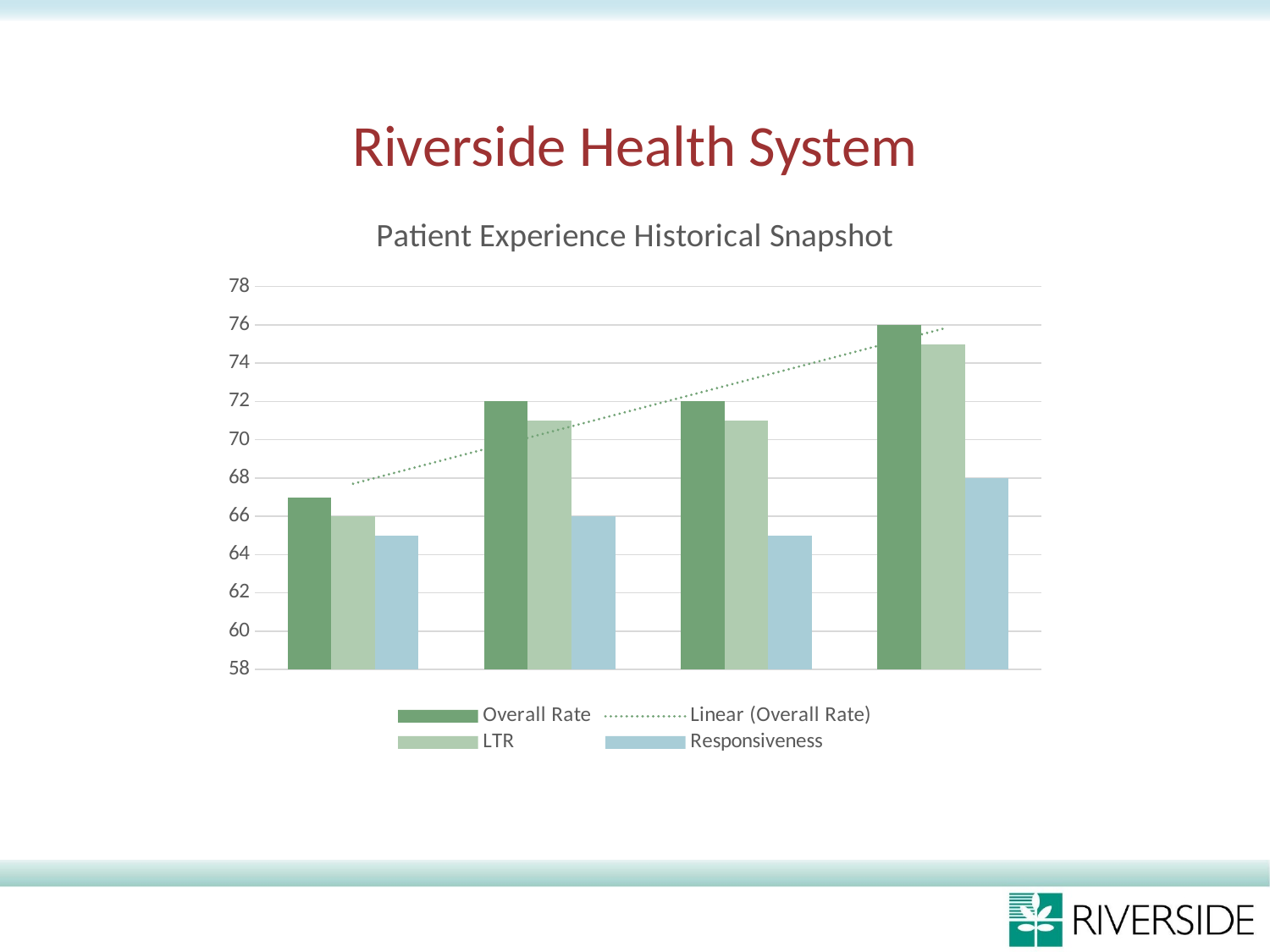
In the leftmost group of bars, which is larger: Overall Rate or Responsiveness? Overall Rate How many groups of bars are plotted in the chart? 4 What is the title of the chart? Patient Experience Historical Snapshot What kind of chart is shown on the slide? bar chart Which series has the lowest bar in every group? Responsiveness In the rightmost group of bars, which series has the highest bar? Overall Rate How many entries does the chart legend list? 4 Is the Overall Rate value in the rightmost group greater or less than 74? greater Does the Overall Rate series generally rise or fall from left to right across the groups? rise Which legend entry is drawn as a dotted line rather than bars? Linear (Overall Rate) Is the Responsiveness value in the rightmost group greater or less than 70? less What is the Overall Rate value in the rightmost group of bars? 76